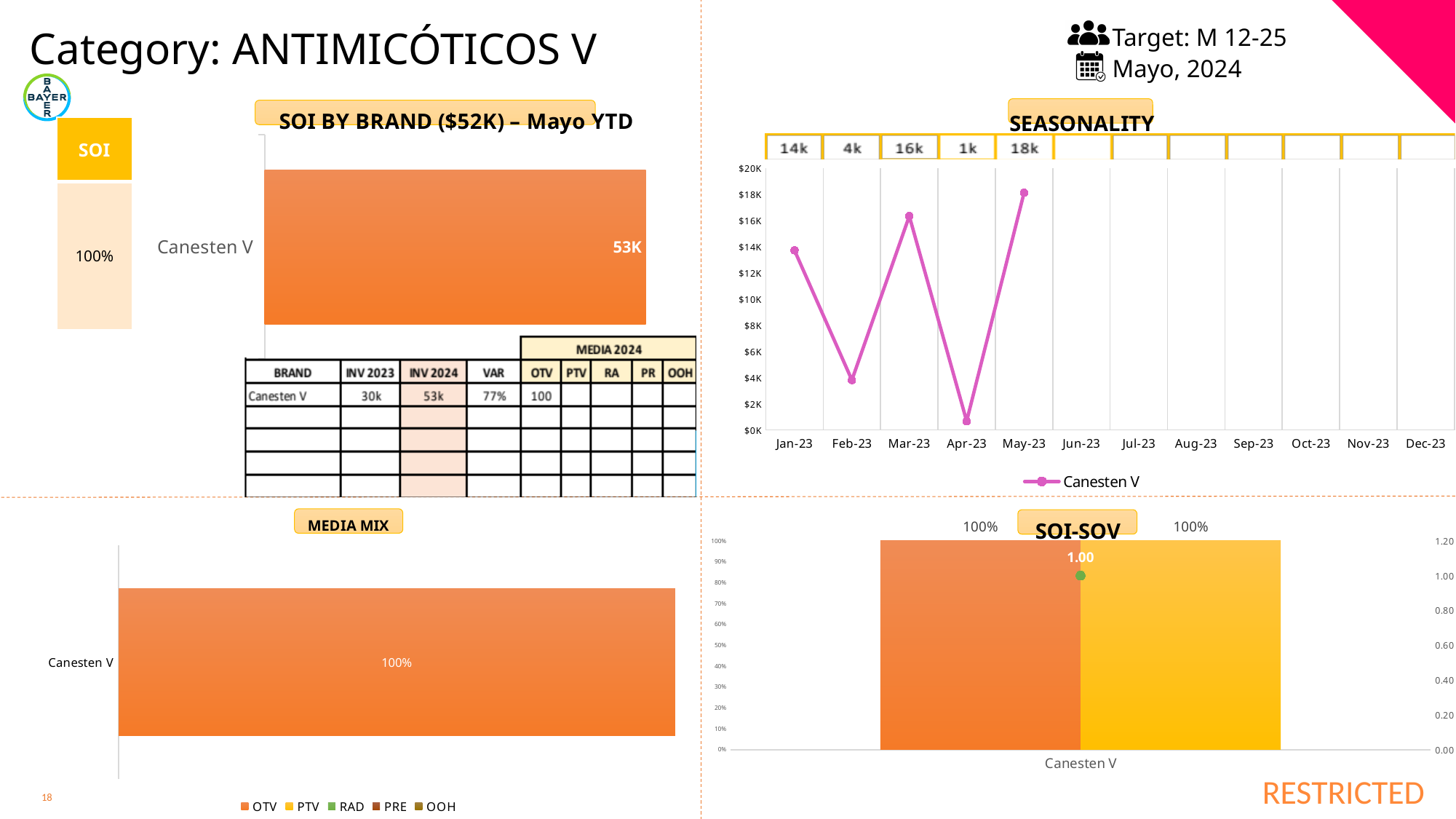
What kind of chart is the SOI BY BRAND chart? bar chart In the SEASONALITY chart, which is larger, the value for Jan-23 or the value for Mar-23? Mar-23 How many brands are plotted in the SOI BY BRAND chart? 1 In the MEDIA MIX chart, what percentage is shown for Canesten V? 100% How many series does the legend of the MEDIA MIX chart list? 5 In the SOI BY BRAND chart, what is the value shown for Canesten V? 53K In the SEASONALITY chart, which month has the lowest value? Apr-23 What kind of chart is the SEASONALITY chart? line chart In the SEASONALITY chart, is the value for Feb-23 greater or less than $6K? less In the SEASONALITY chart, what is the value for Apr-23? 1k In the SEASONALITY chart, what is the value for Mar-23? 16k In the SEASONALITY chart, which month has the highest value? May-23